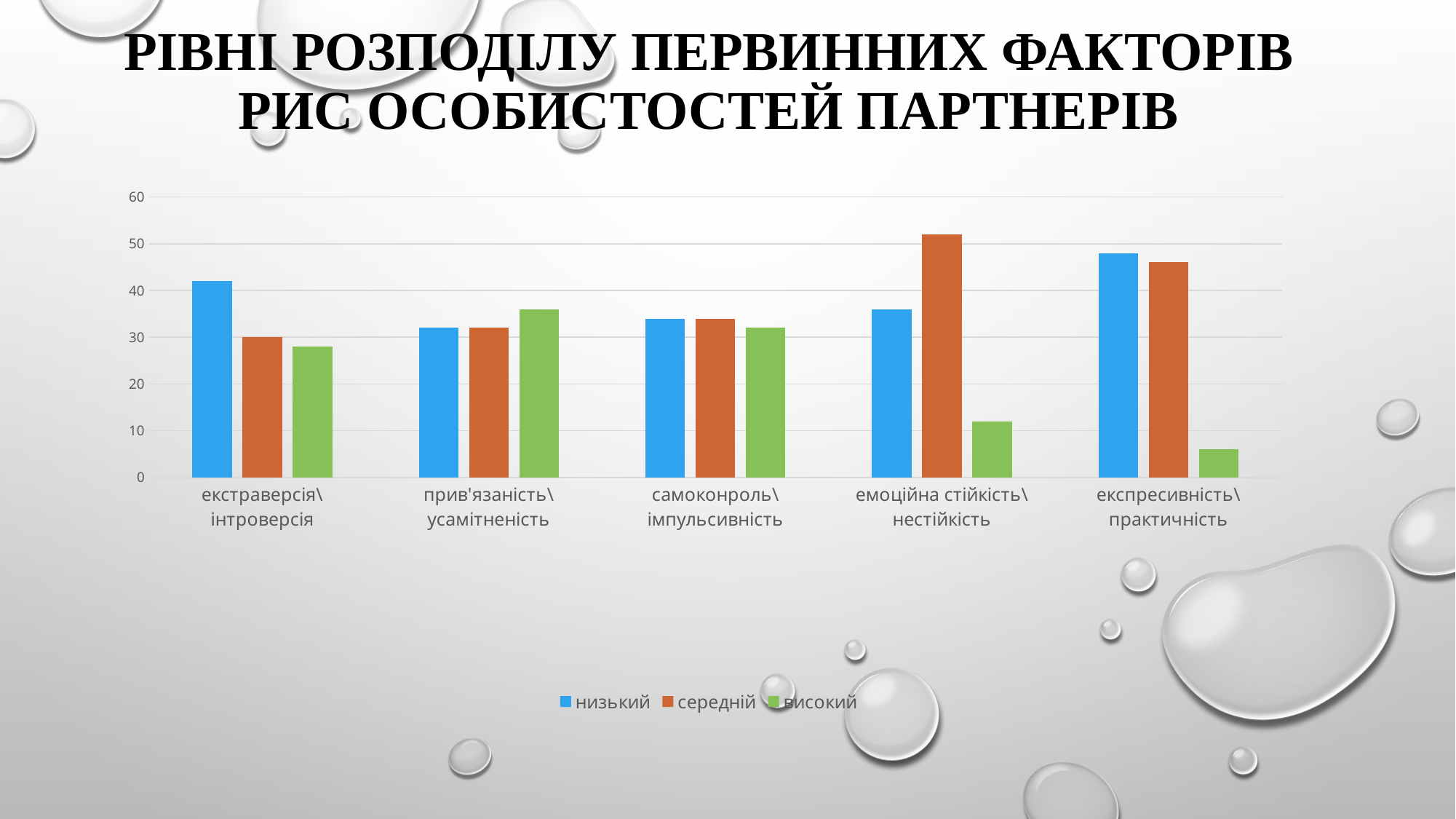
For емоційна стійкість\нестійкість, which is larger: the низький value or the середній value? середній How many categories are shown on the x axis of the chart? 5 Is the високий value for експресивність\практичність greater or less than 10? less Is the низький value for екстраверсія\інтроверсія greater or less than 40? greater How many series does the legend list? 3 Which category has the highest value for the середній series? емоційна стійкість\нестійкість What kind of chart is shown on the slide? bar chart What are the three series named in the legend? низький, середній, високий Is the високий value for прив'язаність\усамітненість greater or less than 30? greater What is the value of the середній series for екстраверсія\інтроверсія? 30 Which category has the lowest value for the високий series? експресивність\практичність